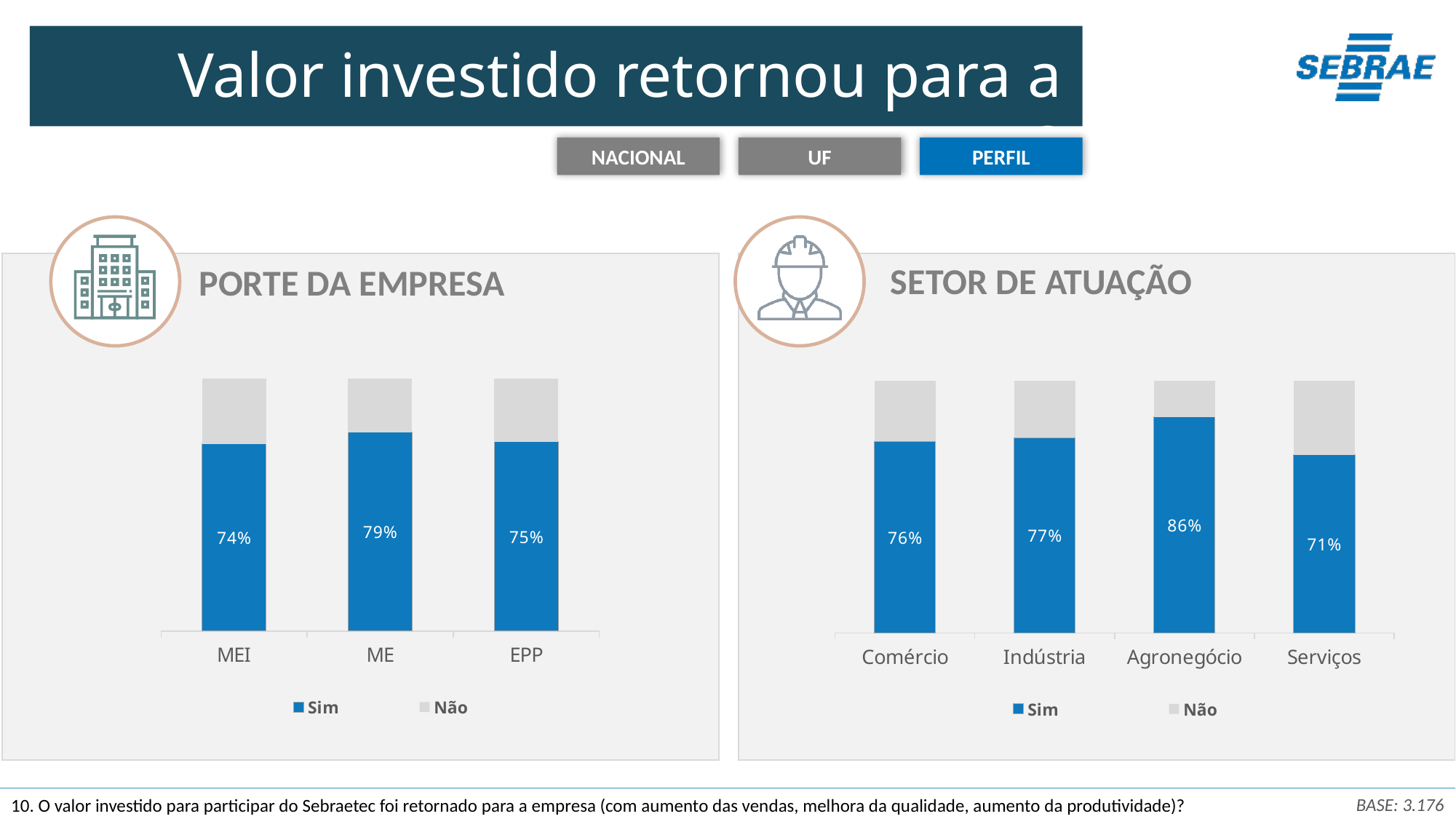
In the SETOR DE ATUAÇÃO chart, which has a larger 'Sim' value, Comércio or Indústria? Indústria In the SETOR DE ATUAÇÃO chart, which category has the lowest 'Sim' value? Serviços In the PORTE DA EMPRESA chart, how many categories are shown on the x axis? 3 In the SETOR DE ATUAÇÃO chart, what is the 'Sim' value for Agronegócio? 86% In the PORTE DA EMPRESA chart, what is the 'Sim' value for ME? 79% In the SETOR DE ATUAÇÃO chart, what is the 'Sim' value for Serviços? 71% In the PORTE DA EMPRESA chart, what is the 'Sim' value for MEI? 74% In the PORTE DA EMPRESA chart, what is the difference between the 'Sim' values for ME and MEI? 5% In the SETOR DE ATUAÇÃO chart, what is the difference between the 'Sim' values for Agronegócio and Serviços? 15% In the PORTE DA EMPRESA chart, which category has the highest 'Sim' value? ME How many series does the legend of the SETOR DE ATUAÇÃO chart list? 2 What kind of chart is the PORTE DA EMPRESA chart? Stacked bar chart